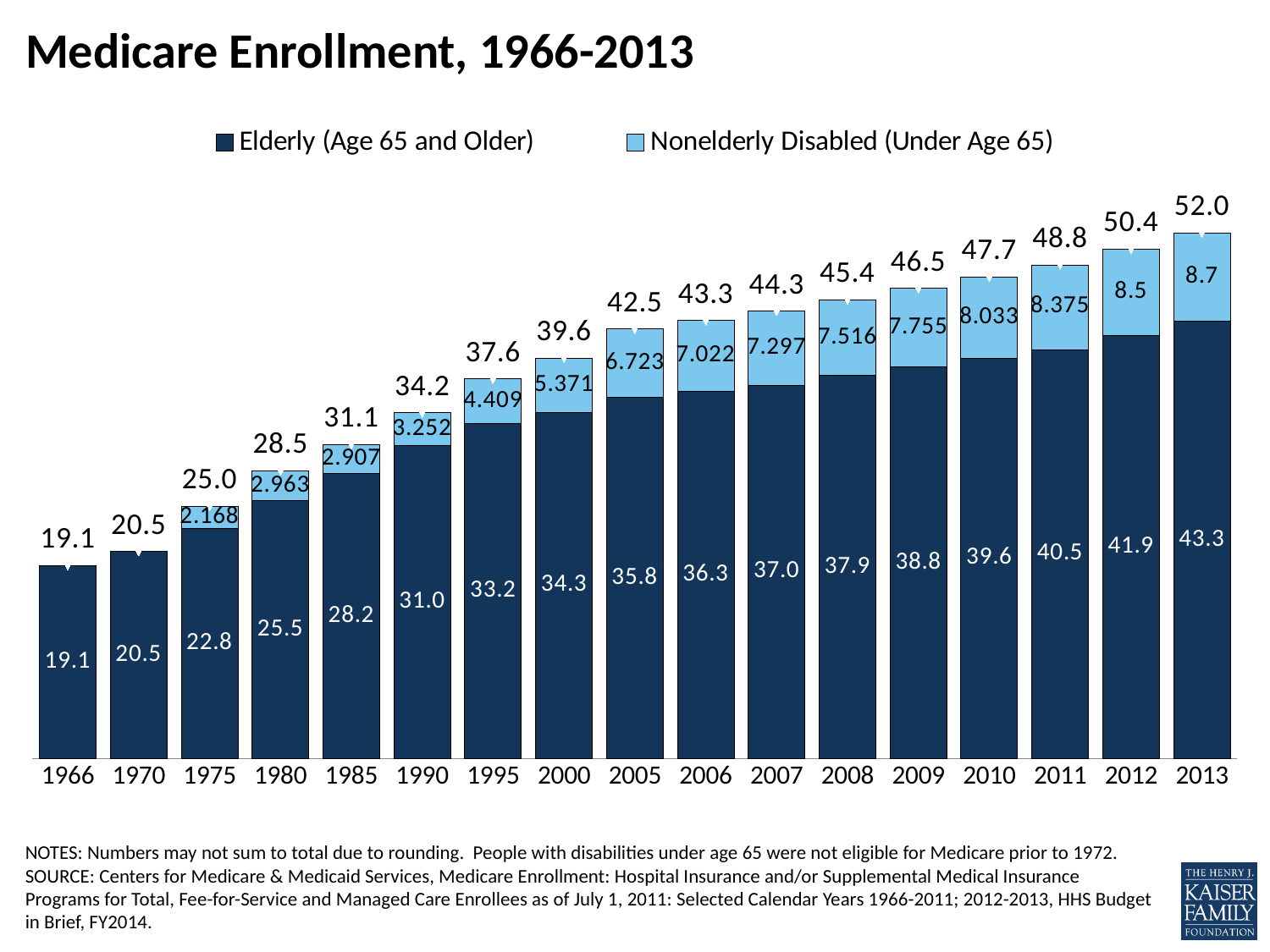
Which year has the highest total enrollment? 2013 What kind of chart is shown on the slide? Stacked bar chart What is the difference between the total enrollment in 2013 and in 2012? 1.6 How many years are shown on the x axis? 17 What is the difference between the Elderly (Age 65 and Older) values for 2013 and 1966? 24.2 What is the value for Elderly (Age 65 and Older) in 2000? 34.3 What is the value for Nonelderly Disabled (Under Age 65) in 2005? 6.723 Do the total enrollment values rise or fall from 1966 to 2013? Rise How many series does the legend list? 2 Which year has the lowest value for Elderly (Age 65 and Older)? 1966 What is the total Medicare enrollment shown above the bar for 2013? 52.0 Which is larger, the Nonelderly Disabled value in 1980 or in 1985? 1980